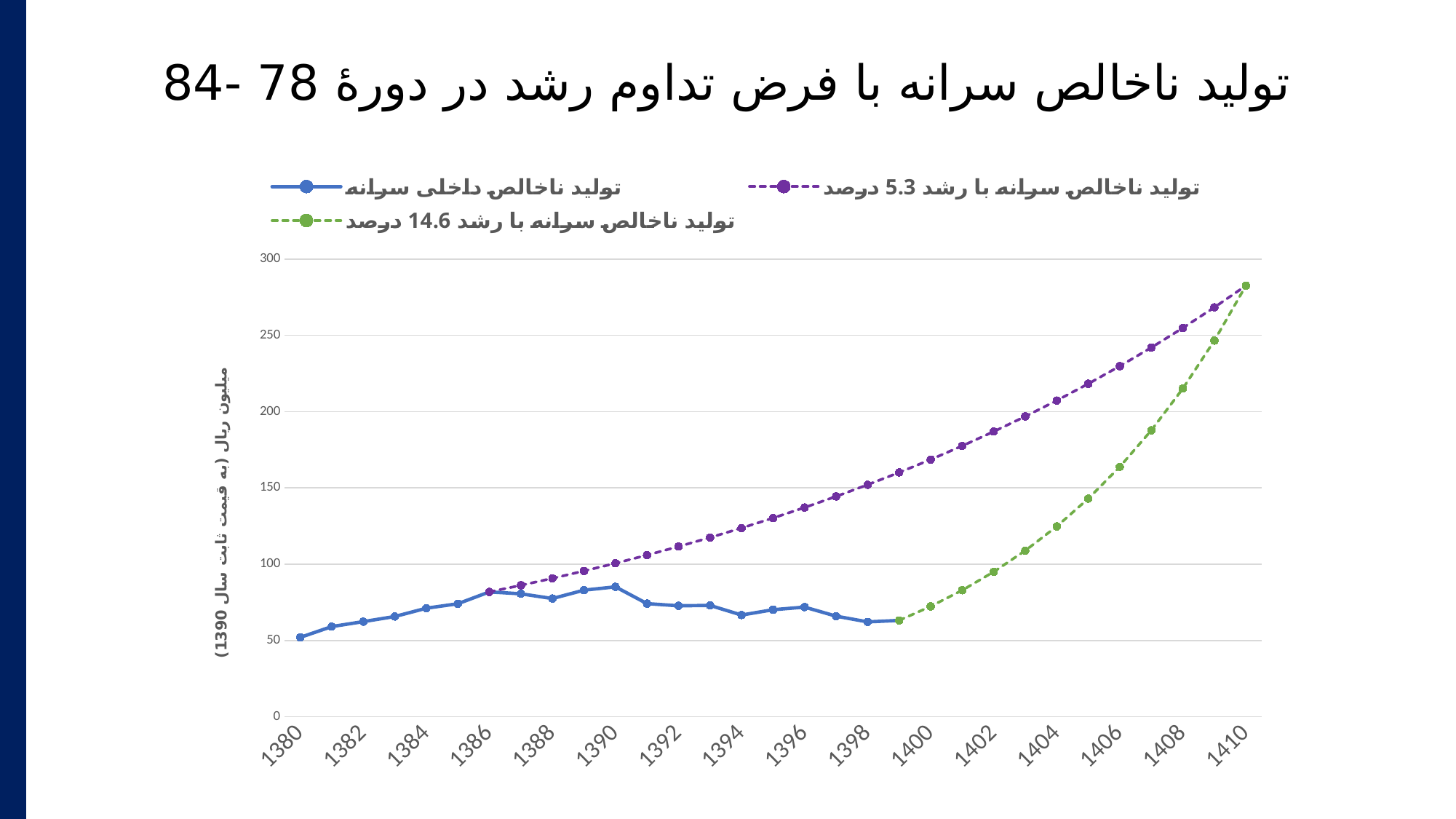
Is the value of the green dashed series (رشد 14.6 درصد) at 1400 greater or less than 100? less What kind of chart is shown on the slide? line chart Is the value of the purple dashed series (رشد 5.3 درصد) at 1410 greater or less than 250? greater What is the highest value shown on the vertical axis? 300 Does the blue series (تولید ناخالص داخلی سرانه) generally rise or fall from 1390 to 1398? fall At 1404, which series has the larger value: the purple dashed series (رشد 5.3 درصد) or the green dashed series (رشد 14.6 درصد)? the purple dashed series (رشد 5.3 درصد) Is the value of the blue series (تولید ناخالص داخلی سرانه) at 1390 greater or less than 100? less How many series does the legend list? 3 Does the purple dashed series (رشد 5.3 درصد) rise or fall as the years increase from 1386 to 1410? rise For the blue series (تولید ناخالص داخلی سرانه), which year has the larger value: 1390 or 1398? 1390